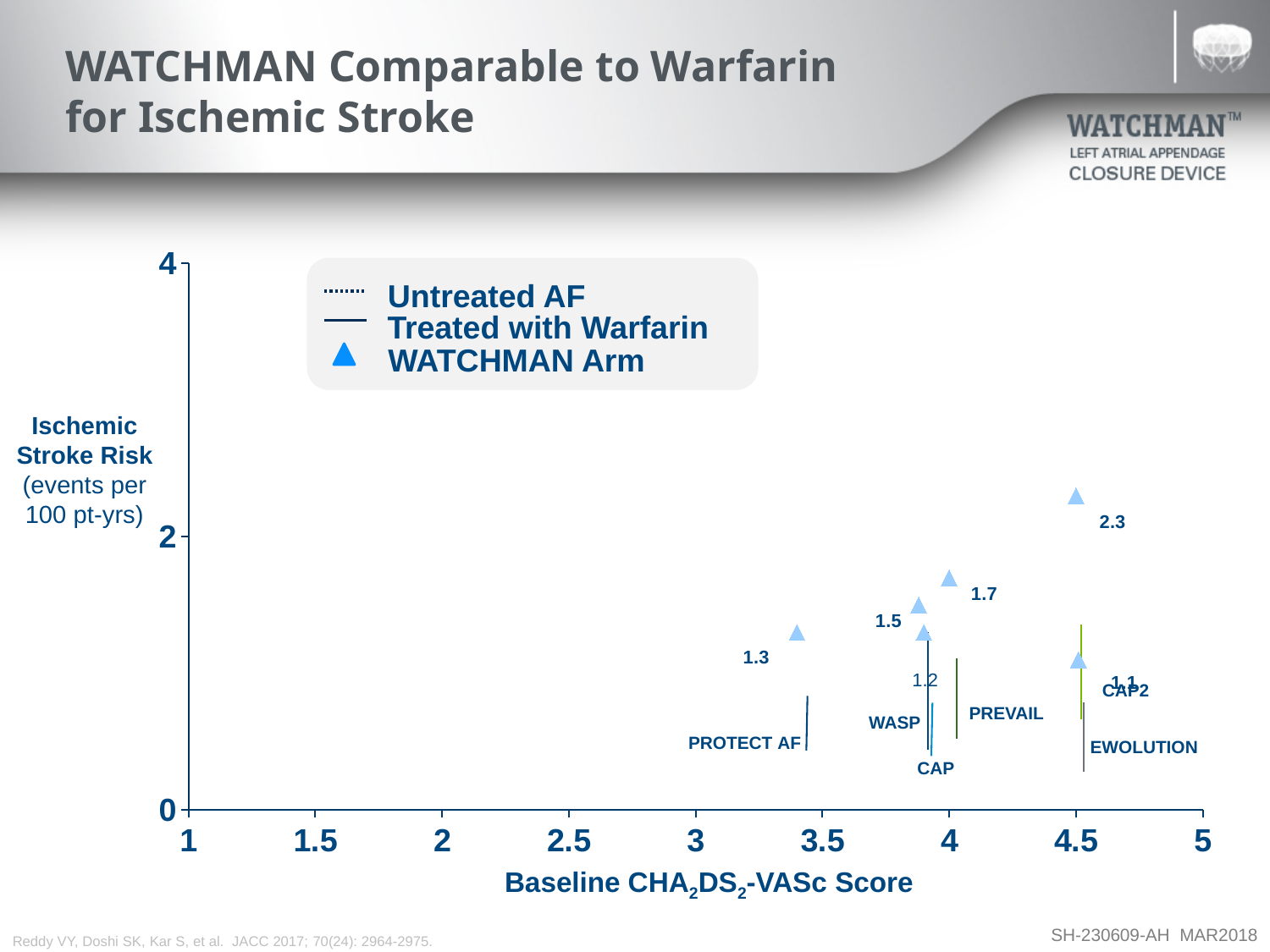
What kind of chart is shown on the slide? scatter chart Which is larger, the point labeled 1.7 or the point labeled 1.5? 1.7 What is the difference between the highest labeled value (2.3) and the lowest labeled value (1.1) on the chart? 1.2 What are the three entries in the chart legend? Untreated AF, Treated with Warfarin, WATCHMAN Arm Is the value of the highest WATCHMAN Arm point greater or less than 2? greater What is the difference between the points labeled 1.7 and 1.3? 0.4 How many entries does the chart legend list? 3 What is the lowest ischemic stroke risk value labeled for a WATCHMAN Arm point? 1.1 How many WATCHMAN Arm triangle points are plotted on the chart? 6 What is the x-axis of the chart labeled? Baseline CHA2DS2-VASc Score What is the ischemic stroke risk value labeled for the PROTECT AF point? 1.3 What is the highest ischemic stroke risk value labeled for a WATCHMAN Arm point? 2.3